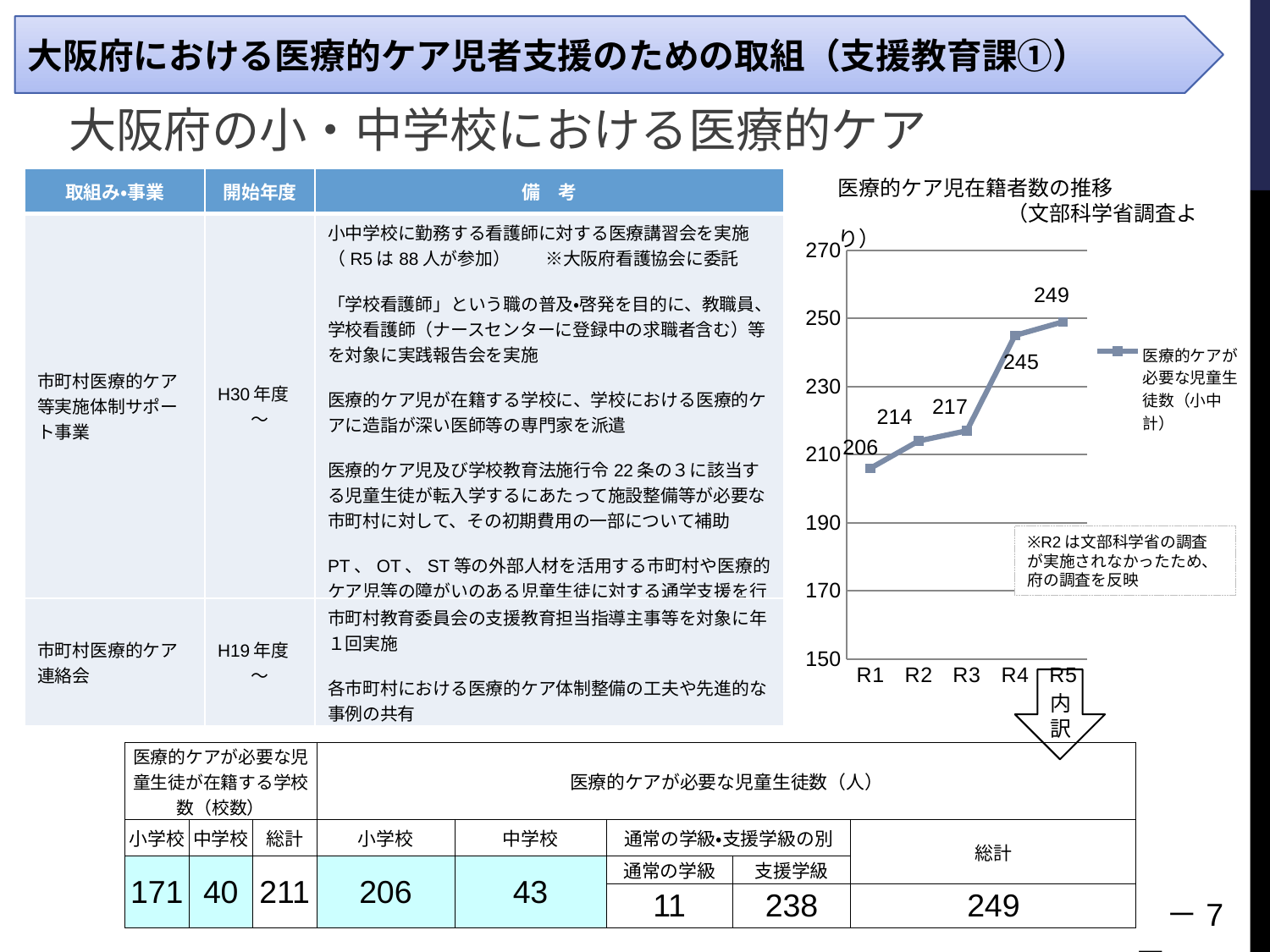
How many years (data points) are plotted in the line chart 医療的ケア児在籍者数の推移? 5 Which year has the lowest value in the line chart 医療的ケア児在籍者数の推移? R1 What is the value for R5 in the line chart 医療的ケア児在籍者数の推移? 249 In the line chart 医療的ケア児在籍者数の推移, what is the difference between the R5 value and the R1 value? 43 In the line chart 医療的ケア児在籍者数の推移, which is larger, the value for R2 or the value for R4? R4 What kind of chart is 医療的ケア児在籍者数の推移? line chart In the line chart 医療的ケア児在籍者数の推移, what is the difference between the R4 value and the R3 value? 28 In the line chart 医療的ケア児在籍者数の推移, is the value for R4 greater or less than 230? greater What is the value for R1 in the line chart 医療的ケア児在籍者数の推移? 206 Which year has the highest value in the line chart 医療的ケア児在籍者数の推移? R5 Do the values in the line chart 医療的ケア児在籍者数の推移 rise or fall from R1 to R5? rise What is the value for R3 in the line chart 医療的ケア児在籍者数の推移? 217